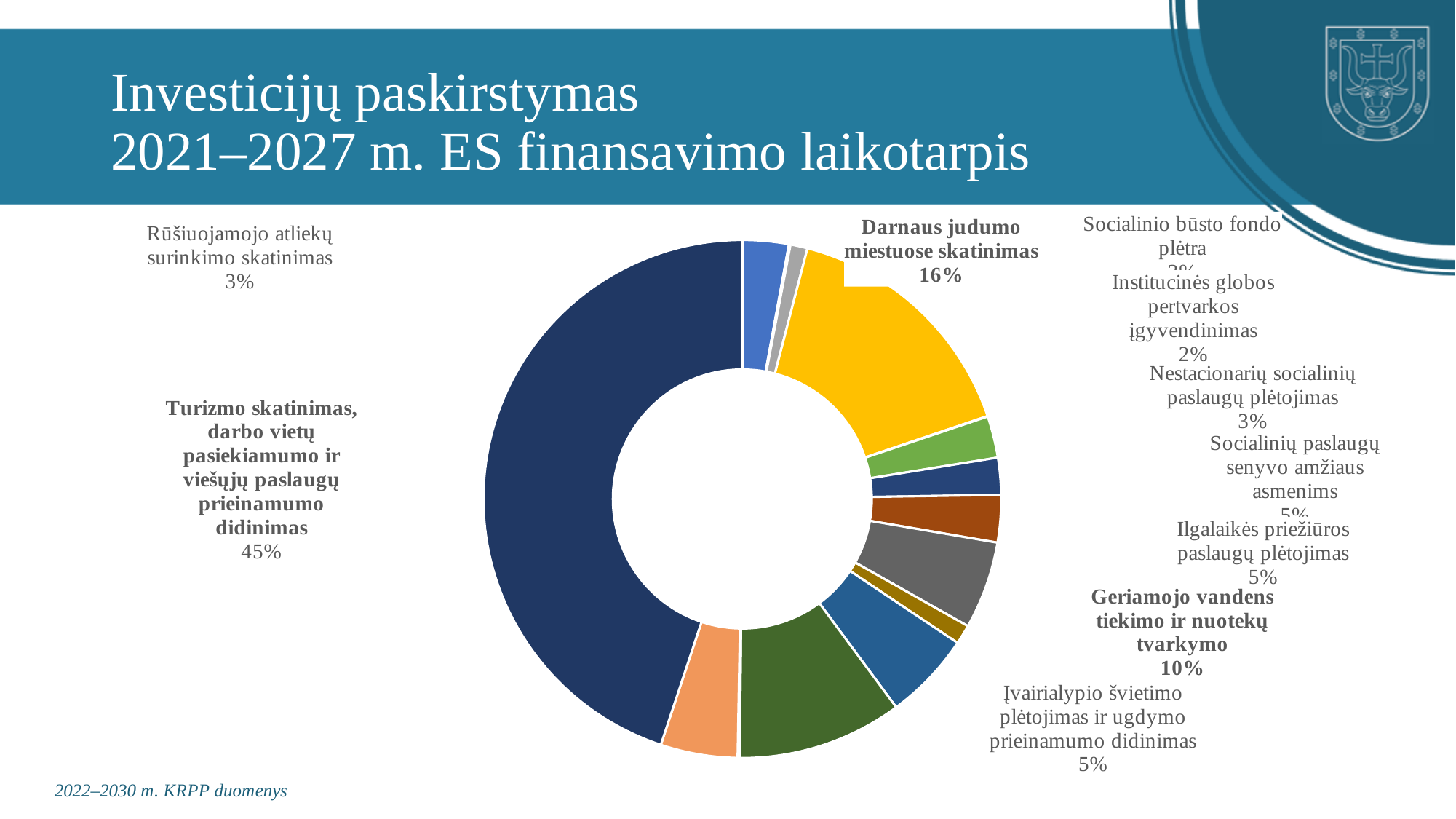
What share of investments goes to "Ilgalaikės priežiūros paslaugų plėtojimas"? 5% What share of investments goes to "Institucinės globos pertvarkos įgyvendinimas"? 2% What share of investments goes to "Geriamojo vandens tiekimo ir nuotekų tvarkymo"? 10% How many percentage points larger is the share for "Turizmo skatinimas, darbo vietų pasiekiamumo ir viešųjų paslaugų prieinamumo didinimas" than for "Darnaus judumo miestuose skatinimas"? 29 percentage points What share of investments goes to "Darnaus judumo miestuose skatinimas"? 16% What share of investments goes to "Turizmo skatinimas, darbo vietų pasiekiamumo ir viešųjų paslaugų prieinamumo didinimas"? 45% Which category has the largest share of investments? Turizmo skatinimas, darbo vietų pasiekiamumo ir viešųjų paslaugų prieinamumo didinimas What share of investments goes to "Rūšiuojamojo atliekų surinkimo skatinimas"? 3% What share of investments goes to "Įvairialypio švietimo plėtojimas ir ugdymo prieinamumo didinimas"? 5% Which has a larger share: "Geriamojo vandens tiekimo ir nuotekų tvarkymo" or "Nestacionarių socialinių paslaugų plėtojimas"? Geriamojo vandens tiekimo ir nuotekų tvarkymo What is the title of the slide containing the chart? Investicijų paskirstymas 2021–2027 m. ES finansavimo laikotarpis What kind of chart is shown on the slide? Pie chart (doughnut)